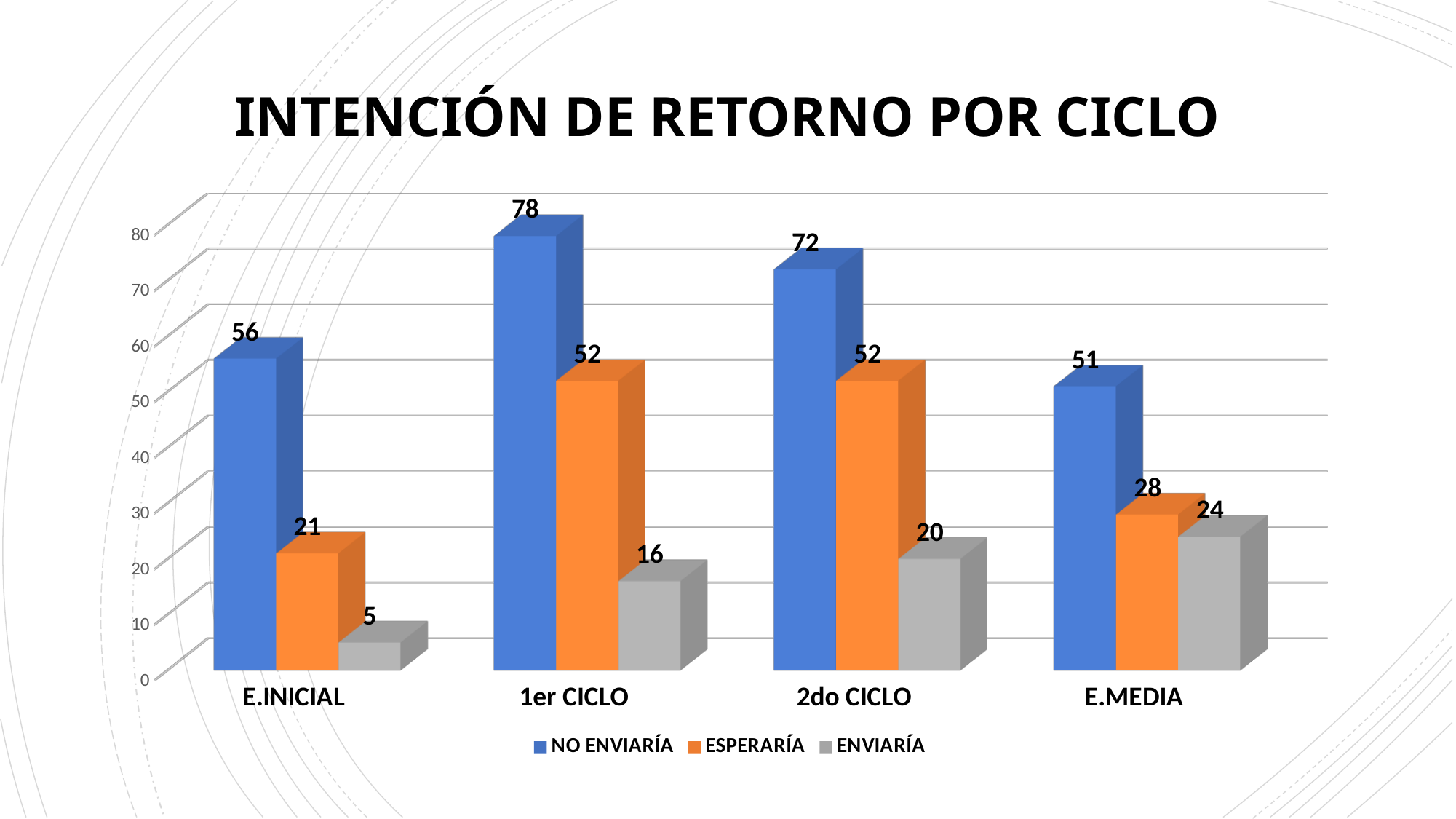
What is the value for ENVIARÍA in E.INICIAL? 5 How many series does the legend list? 3 What is the value for NO ENVIARÍA in 1er CICLO? 78 What kind of chart is shown? Bar chart How many categories are shown on the x axis? 4 Which colour represents the ESPERARÍA series? Orange What is the value for ESPERARÍA in E.MEDIA? 28 Which category has the lowest ENVIARÍA value? E.INICIAL Which category has the highest NO ENVIARÍA value? 1er CICLO Which is larger in E.MEDIA: ESPERARÍA or ENVIARÍA? ESPERARÍA What is the difference between the NO ENVIARÍA values for 1er CICLO and E.MEDIA? 27 What is the title of the chart? INTENCIÓN DE RETORNO POR CICLO